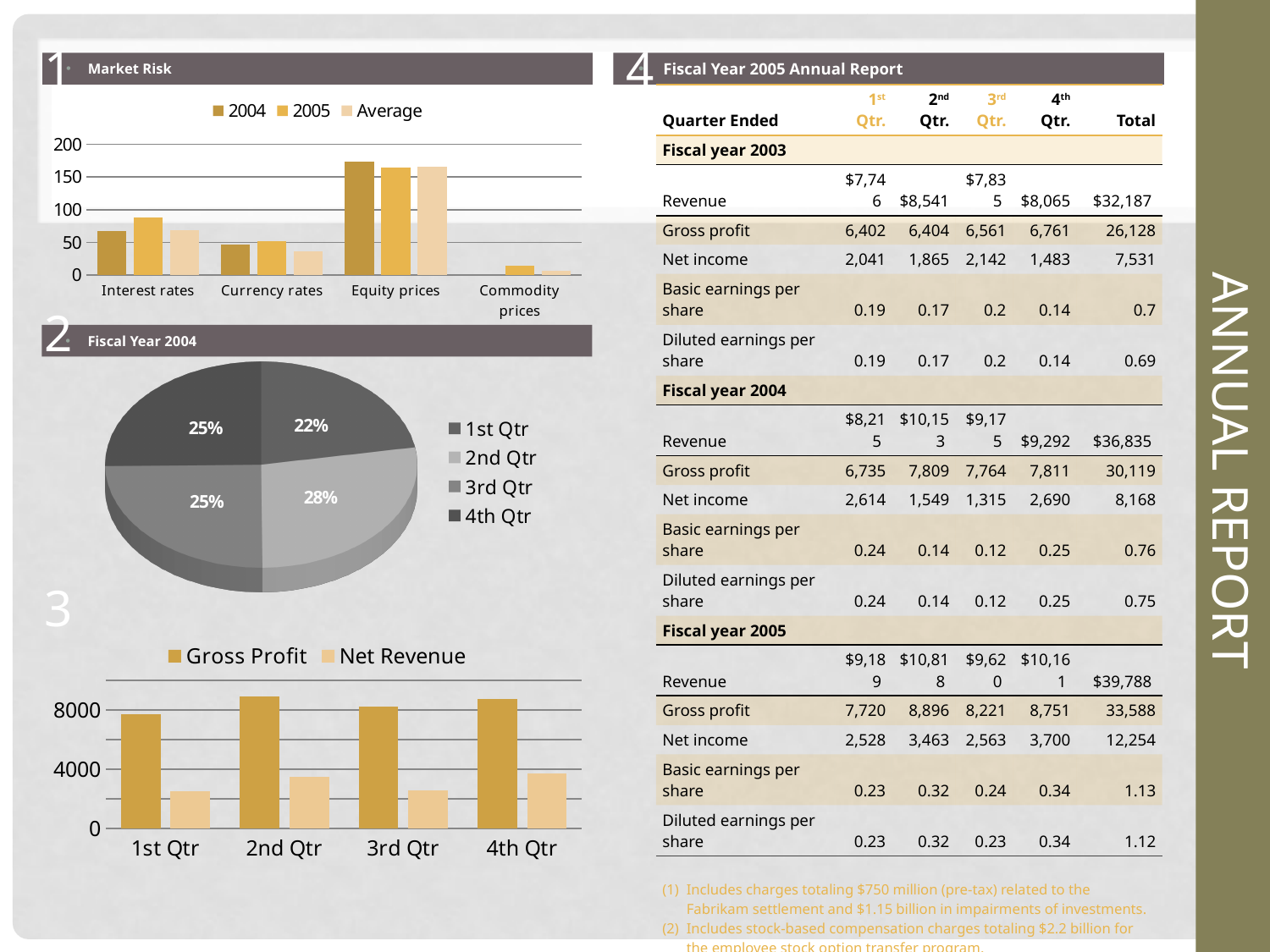
How many categories are shown on the x axis of the Market Risk chart? 4 In the Market Risk chart, is the 2005 value for Currency rates greater or less than 100? less In the Market Risk chart, which category has the highest values? Equity prices In the bottom-left chart, which series has the larger values in every quarter, Gross Profit or Net Revenue? Gross Profit In the Fiscal Year 2004 pie chart, which quarter has the smallest share? 1st Qtr In the Market Risk chart, is the 2004 value for Equity prices greater or less than 150? greater In the Market Risk chart, which category has the lowest values? Commodity prices How many series does the legend of the Market Risk chart list? 3 In the Fiscal Year 2004 pie chart, what share does 2nd Qtr have? 28% What kind of chart is the Fiscal Year 2004 chart? Pie chart In the bottom-left chart, is the Gross Profit value for 2nd Qtr greater or less than 8000? greater In the Fiscal Year 2004 pie chart, what is the difference between the 2nd Qtr share and the 1st Qtr share? 6%